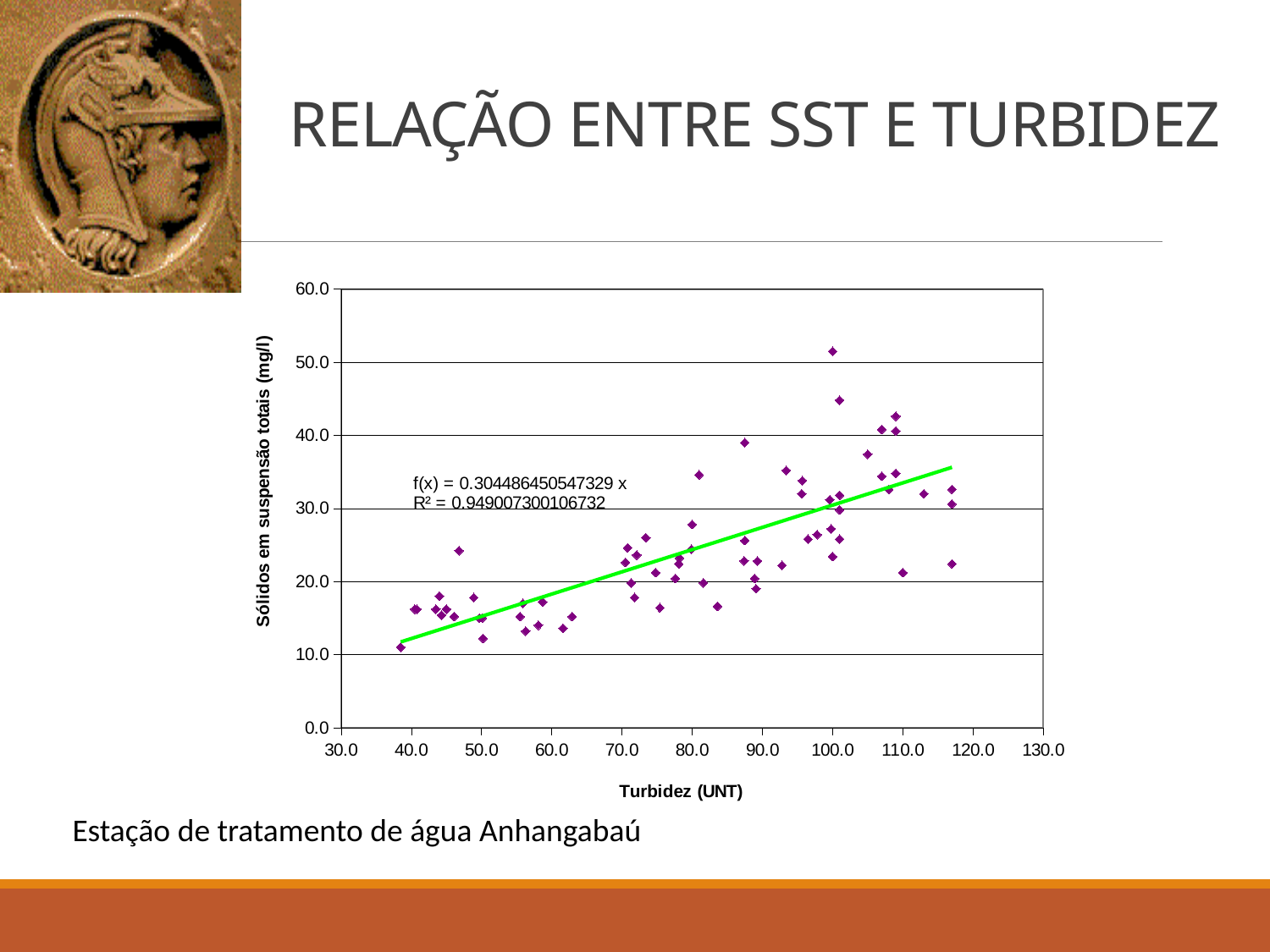
Is the trendline value at a turbidity of 100.0 greater or less than 40.0? less What kind of chart is shown on the slide? scatter chart Do the suspended solids values generally rise or fall as turbidity increases along the x axis? rise What is the title of the vertical axis of the chart? Sólidos em suspensão totais (mg/l) Is the suspended solids value of the point plotted at a turbidity of about 100.0 near the top of the chart greater or less than 50.0? greater What is the title of the horizontal axis of the chart? Turbidez (UNT) What R² value is printed on the chart? 0.949007300106732 Is the highest suspended solids value plotted on the chart greater or less than 50.0? greater What trendline equation is printed on the chart? f(x) = 0.304486450547329 x